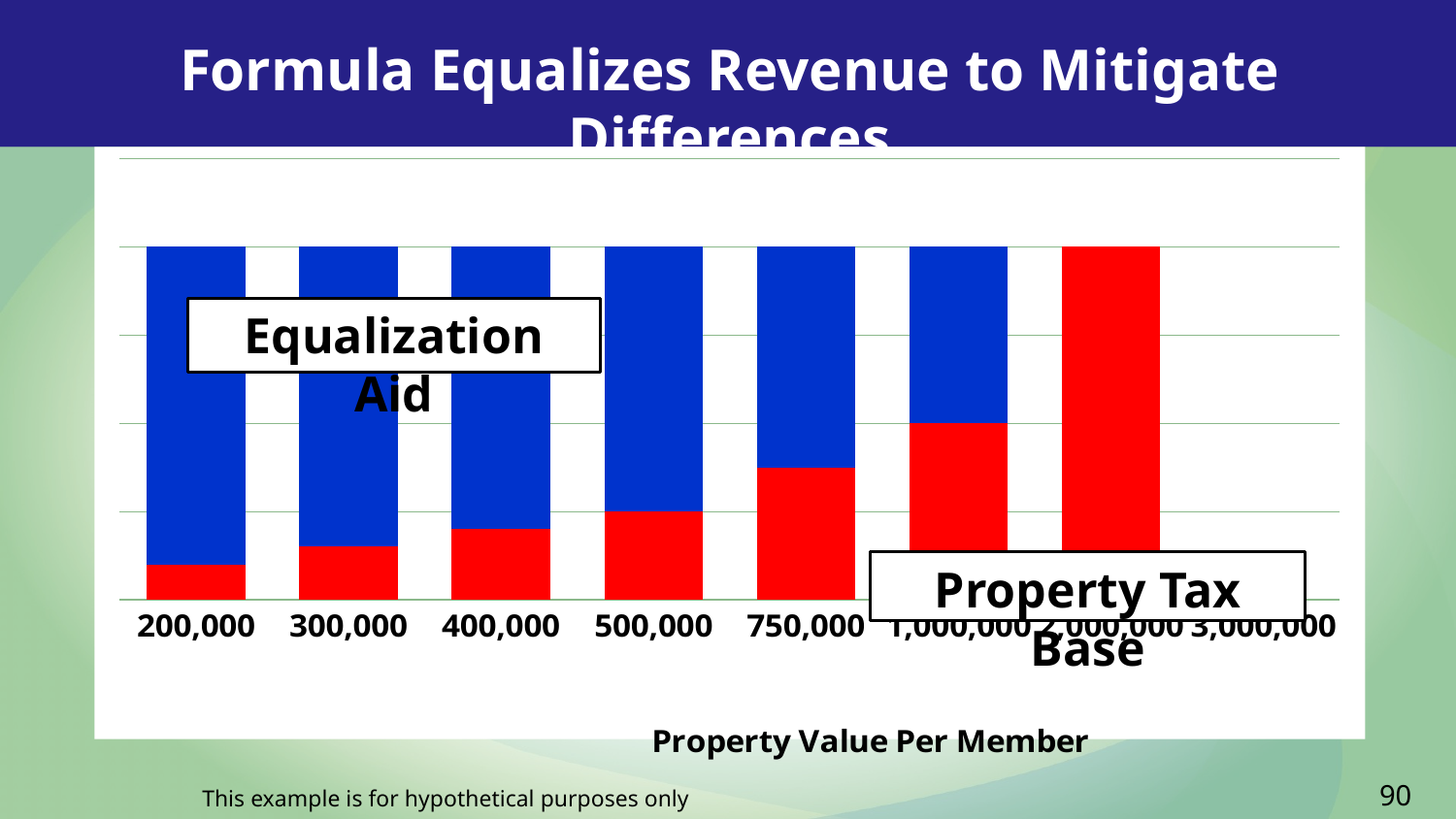
Does the Equalization Aid portion rise or fall as property value per member increases along the x axis? Fall Which category has the largest Property Tax Base (red) portion? 2,000,000 What kind of chart is shown on the slide? Stacked bar chart Does the Property Tax Base portion rise or fall as property value per member increases along the x axis? Rise What is the title of the x axis? Property Value Per Member Which category has the largest Equalization Aid (blue) portion? 200,000 Which has the larger Property Tax Base portion, 500,000 or 1,000,000? 1,000,000 Which category has the smallest Property Tax Base (red) portion? 200,000 How many property value categories are shown along the x axis? 8 Which category receives no Equalization Aid (no blue portion)? 2,000,000 How many series are shown in the chart? 2 Which colour represents Equalization Aid in the chart? Blue